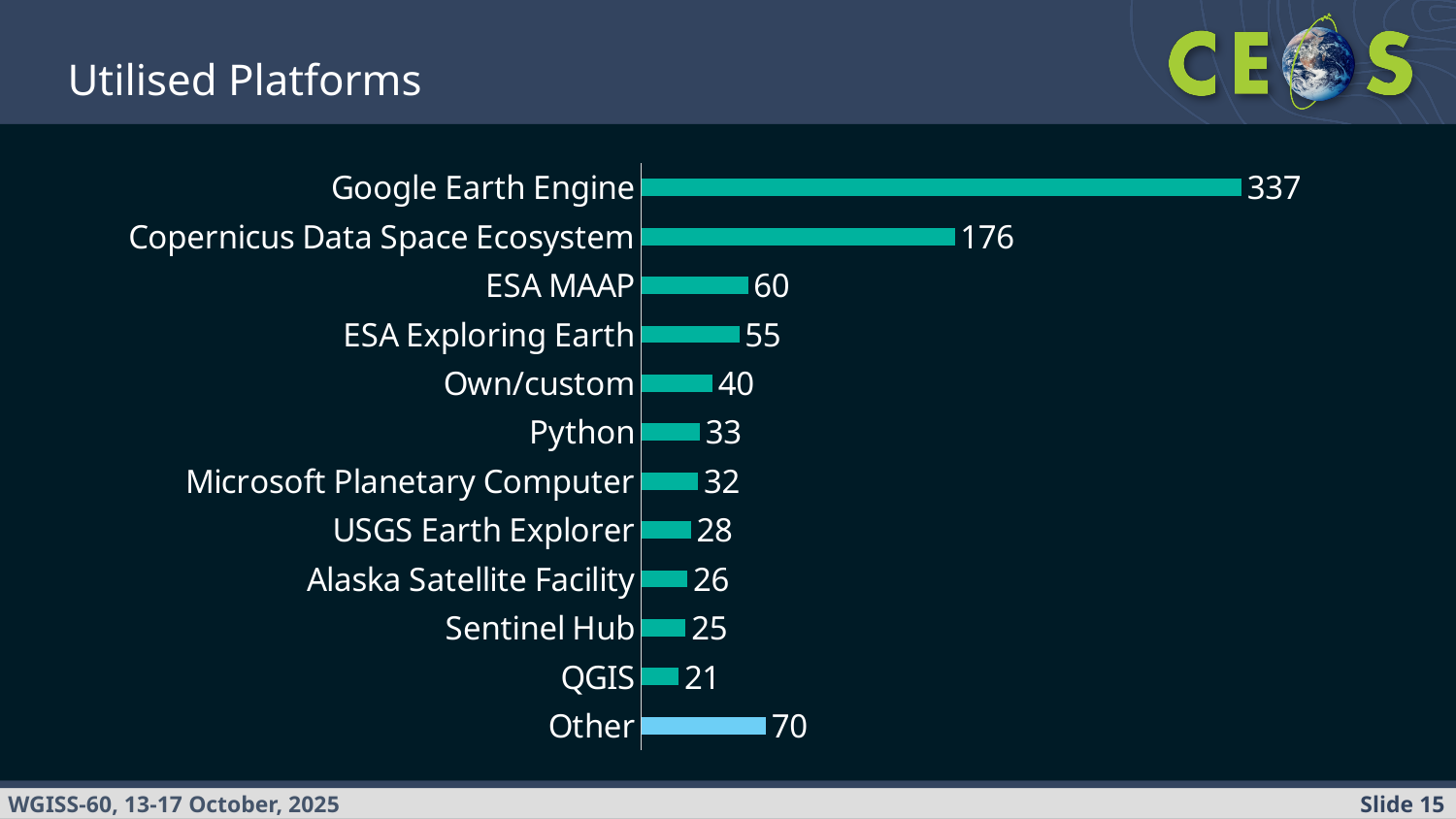
What is the value for Other? 70 What is the value for Microsoft Planetary Computer? 32 Which has a larger value, Own/custom or Python? Own/custom What is the difference between the values for ESA MAAP and ESA Exploring Earth? 5 Which platform has the highest value? Google Earth Engine What is the value for Copernicus Data Space Ecosystem? 176 Which bar is shown in a different colour from the others? Other How many platforms are shown in the chart? 12 What is the difference between the values for Google Earth Engine and Copernicus Data Space Ecosystem? 161 Which platform has the lowest value? QGIS What kind of chart is shown on the slide? Bar chart What is the value for Google Earth Engine? 337